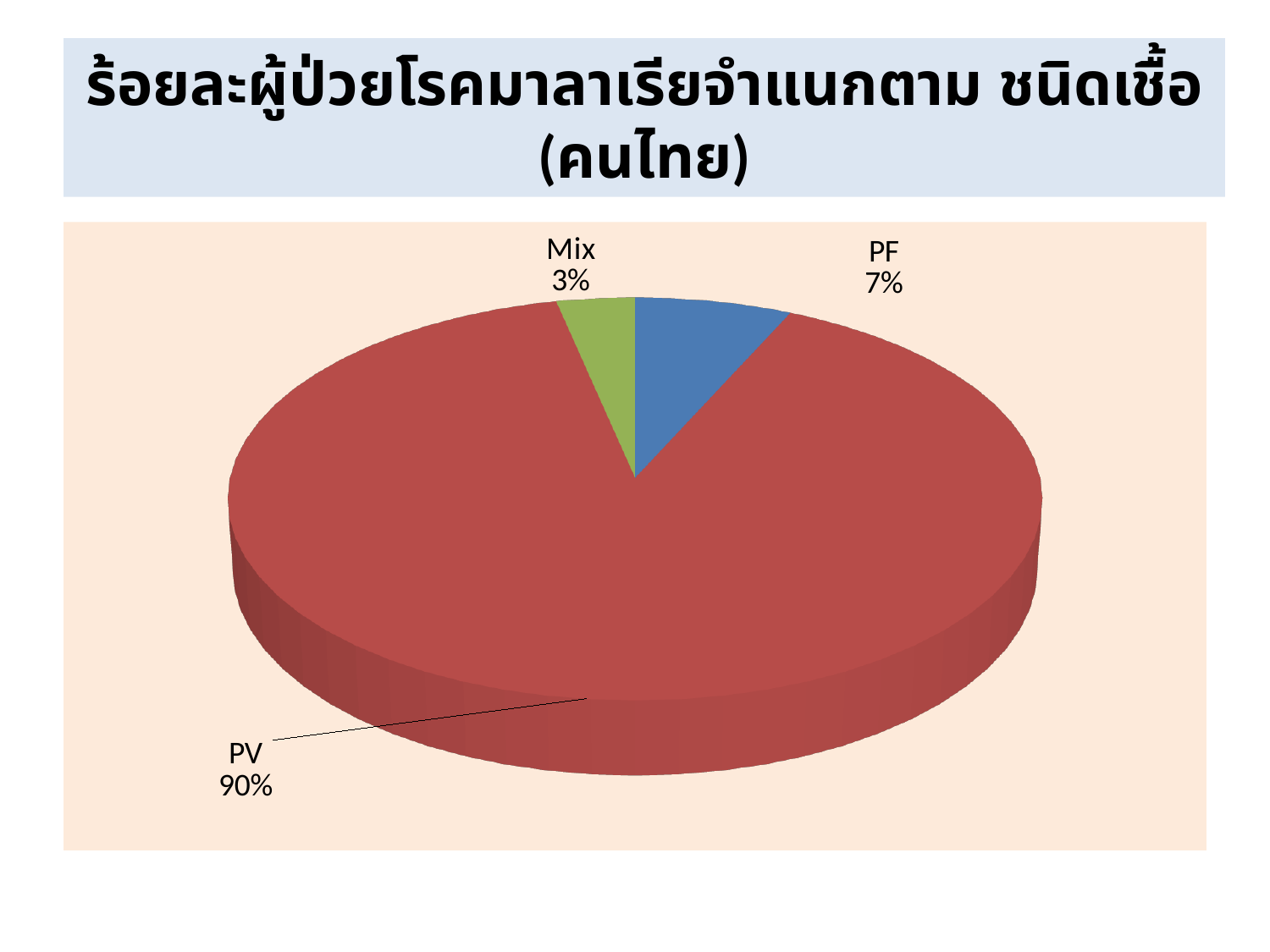
What percentage of the pie does Mix account for? 3% Which is larger, the share for PF or the share for Mix? PF What is the difference in percentage points between PV and PF? 83 Which category has the largest share of the pie? PV What colour is the Mix slice? Green What colour is the PV slice? Red What percentage of the pie does PF account for? 7% What kind of chart is shown on the slide? Pie chart What is the difference in percentage points between PF and Mix? 4 How many slices does the pie chart have? 3 What percentage of the pie does PV account for? 90% Which category has the smallest share of the pie? Mix